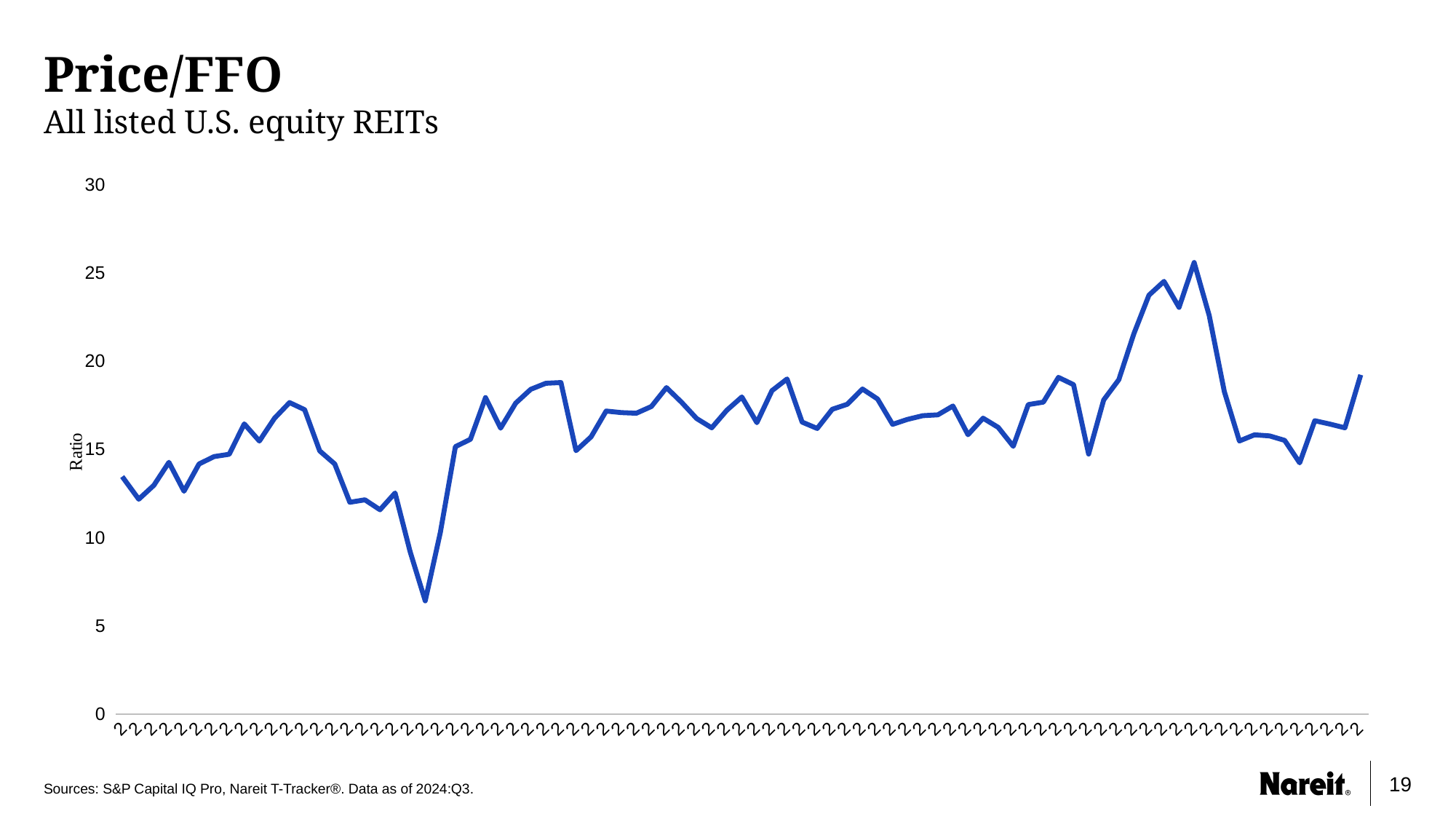
What is the title of the chart on the slide? Price/FFO Is the value at the end of the line higher or lower than the value at the start of the line? higher Does the line ever rise above 30 on the vertical axis? No Is the last value on the line greater or less than 15? greater Is the highest point on the line greater or less than 20? greater What label is shown on the vertical axis of the chart? Ratio What is the highest tick value shown on the vertical axis? 30 What kind of chart is shown on the slide? Line chart How many lines are plotted on the chart? 1